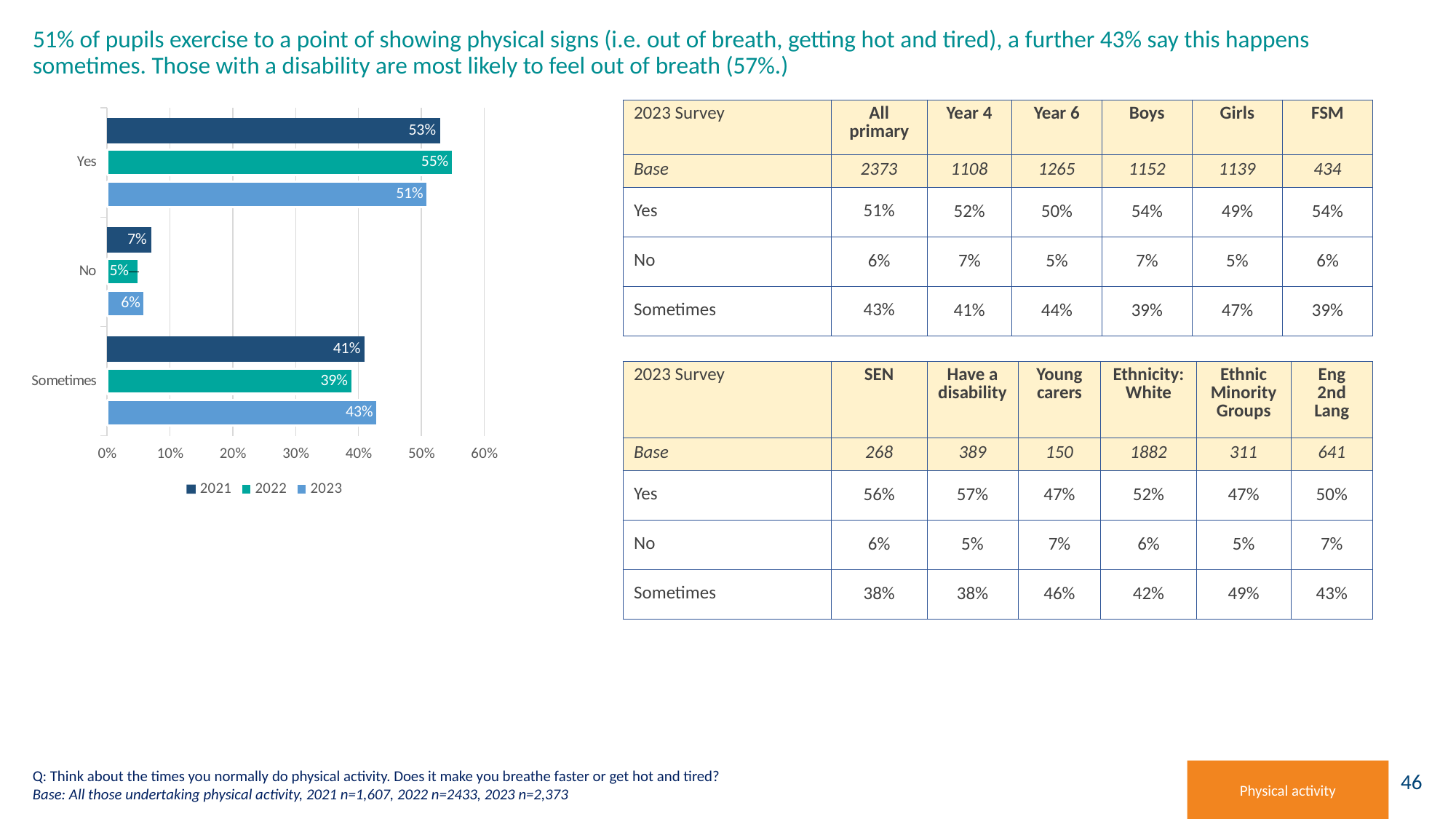
Which year has the lowest value for 'No'? 2022 What is the value for 'Yes' in the 2023 series? 51% Which series is shown in the darkest blue colour? 2021 How many series does the legend list? 3 What kind of chart is shown on the slide? bar chart How many categories are shown on the chart? 3 What is the value for 'Sometimes' in the 2022 series? 39% Which is larger: the 2021 value for 'Sometimes' or the 2023 value for 'Sometimes'? 2023 What is the value for 'No' in the 2021 series? 7% Which year has the highest value for 'Yes'? 2022 What is the difference between the 2022 and 2023 values for 'Yes'? 4% Is the 2021 value for 'Yes' greater or less than 50%? greater